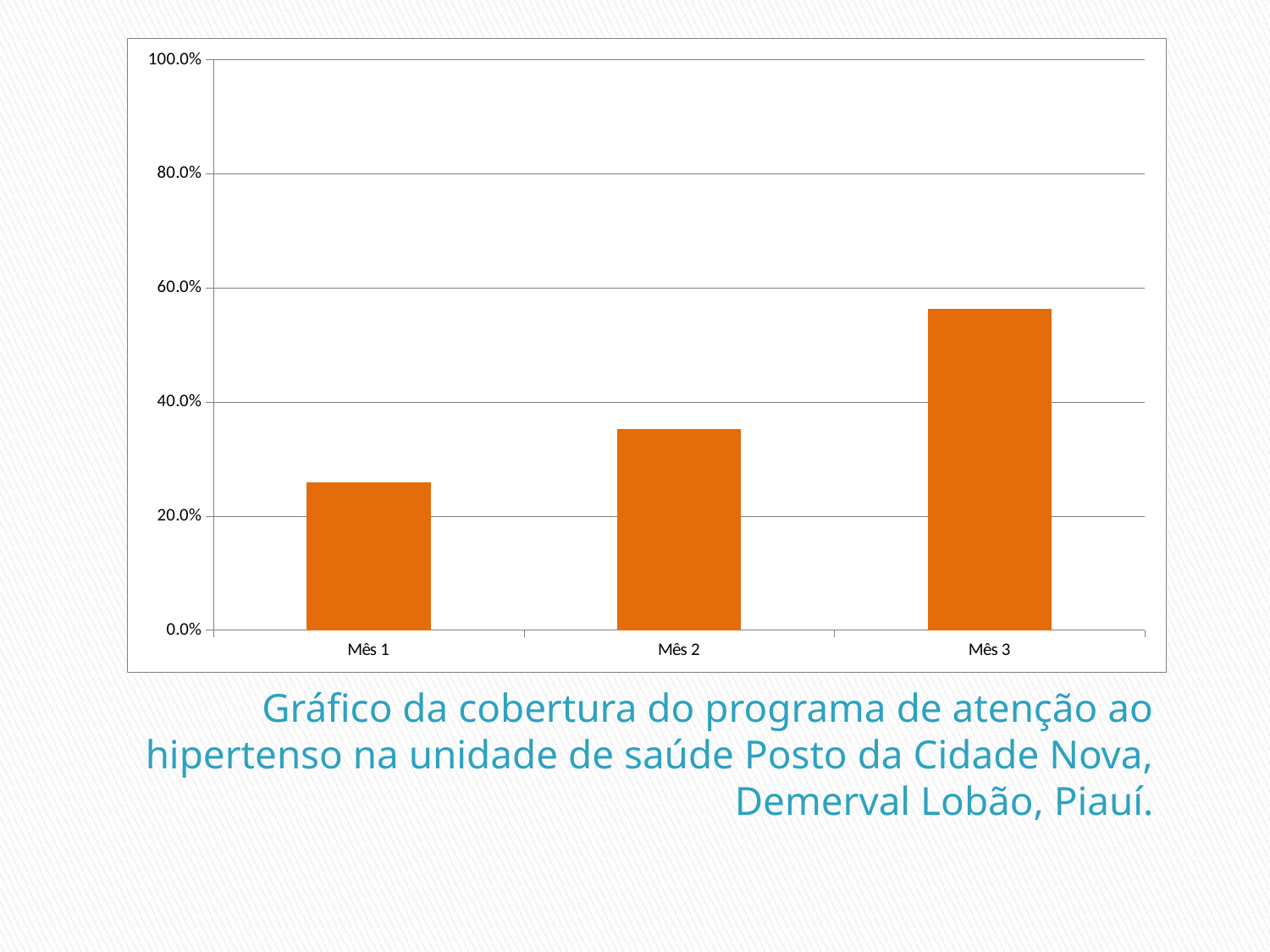
Is the value for Mês 2 greater or less than 40.0%? less Which is larger, the value for Mês 2 or the value for Mês 3? Mês 3 Which month has the lowest coverage value? Mês 1 Which month has the highest coverage value? Mês 3 Is the value for Mês 3 greater or less than 40.0%? greater Is the value for Mês 1 greater or less than 40.0%? less What is the highest value shown on the vertical axis? 100.0% How many months (categories) are plotted on the chart? 3 What kind of chart is shown on the slide? bar chart Do the values rise or fall from Mês 1 to Mês 3? rise